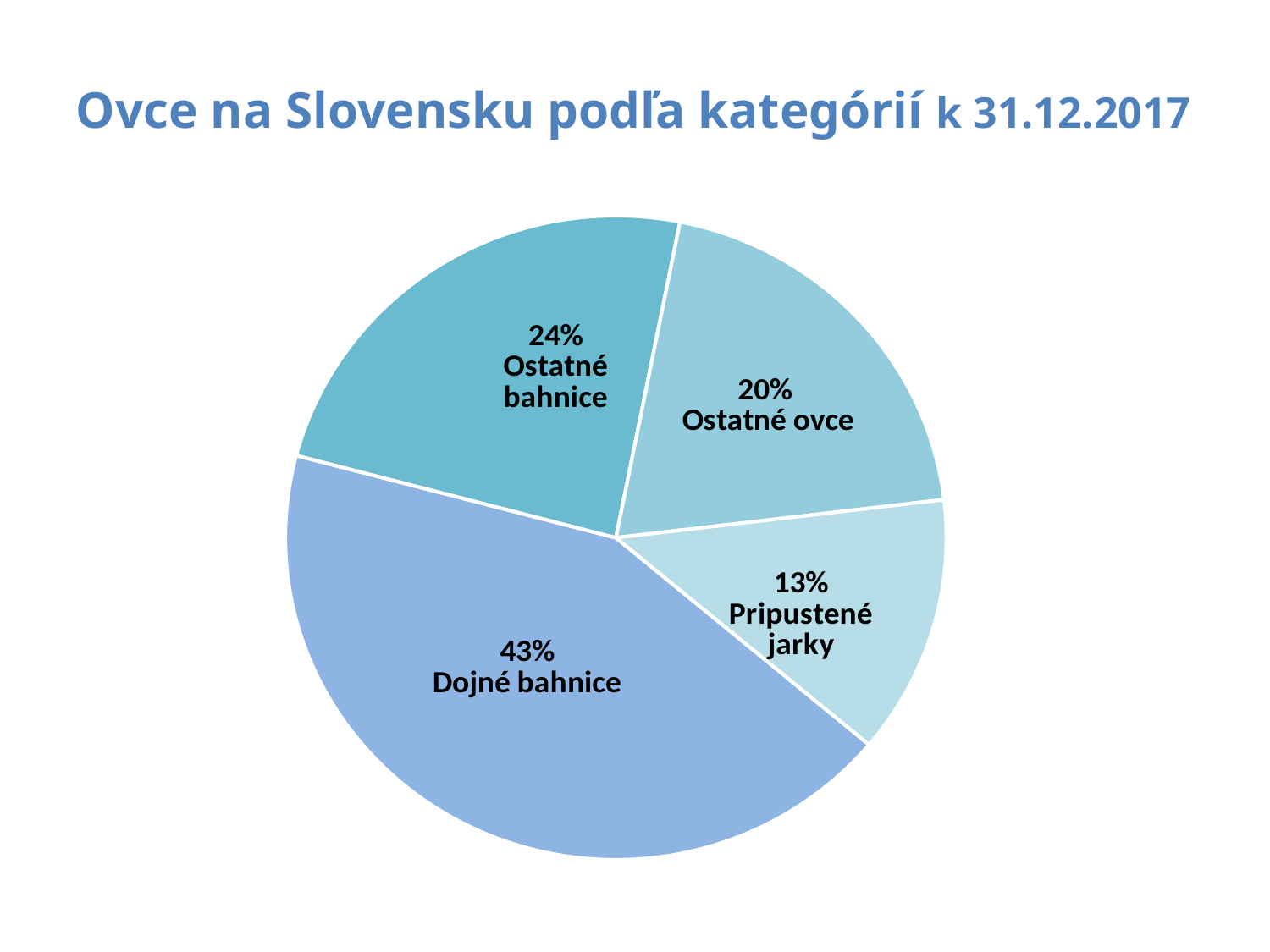
What share of the pie does Ostatné bahnice represent? 24% What is the difference in percentage points between Ostatné ovce and Pripustené jarky? 7 What is the difference in percentage points between Dojné bahnice and Ostatné bahnice? 19 What share of the pie does Pripustené jarky represent? 13% What is the title of the chart? Ovce na Slovensku podľa kategórií k 31.12.2017 Which category has the largest share of the pie? Dojné bahnice Which category has the smallest share of the pie? Pripustené jarky How many categories are shown in the pie chart? 4 What kind of chart is shown on the slide? pie chart What share of the pie does Ostatné ovce represent? 20% Which is larger, the share for Ostatné bahnice or the share for Ostatné ovce? Ostatné bahnice